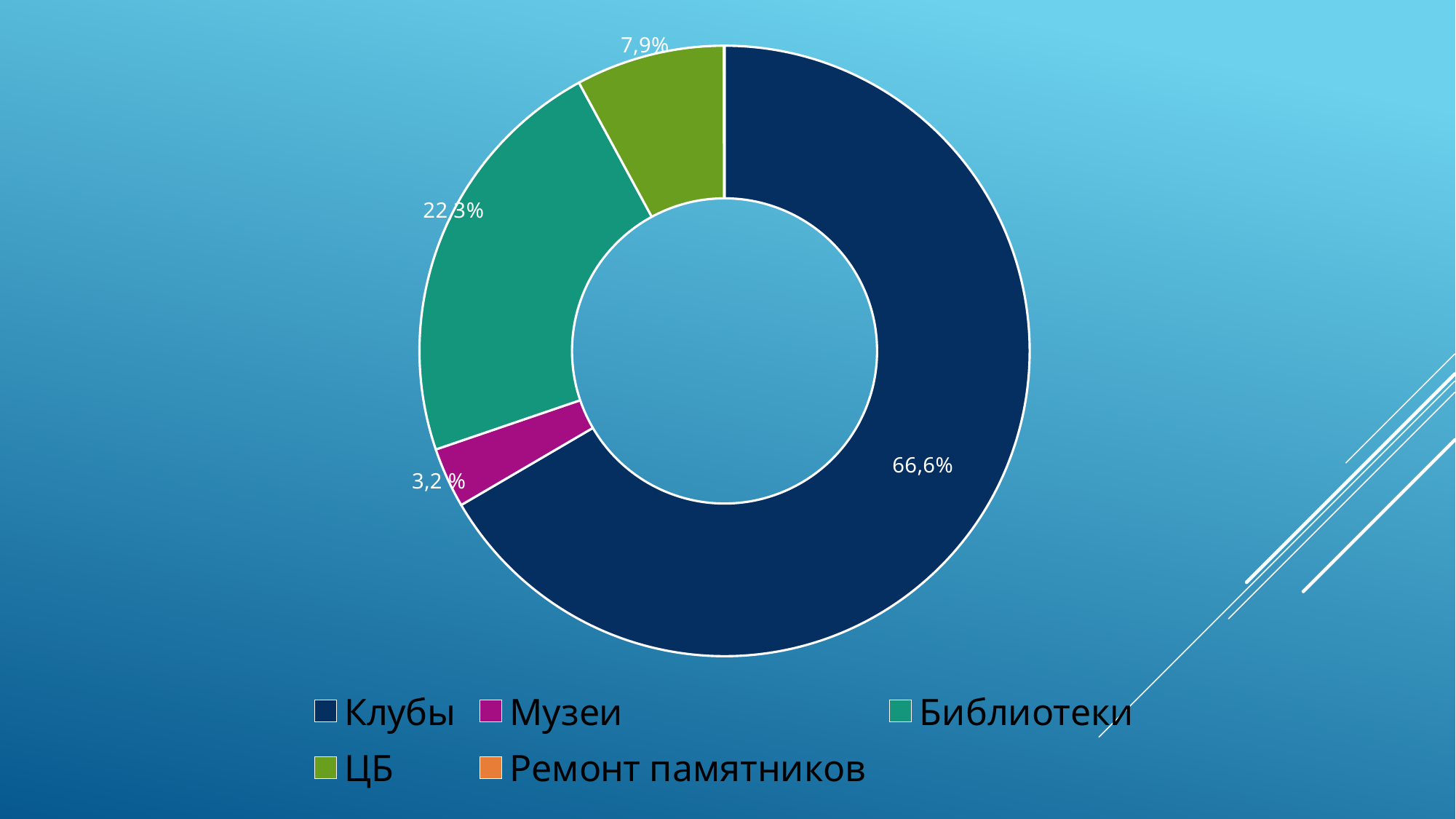
What percentage is shown for ЦБ? 7,9% What colour is the Музеи slice? magenta What is the difference in percentage points between Библиотеки and ЦБ? 14,4 What percentage is shown for Библиотеки? 22,3% Which category has the largest share of the chart? Клубы How many categories does the legend list? 5 What percentage is shown for Музеи? 3,2 % Which labelled category has the smallest share of the chart? Музеи What percentage is shown for Клубы? 66,6% What is the difference in percentage points between Клубы and Библиотеки? 44,3 What kind of chart is shown on the slide? doughnut chart Which has a larger share, Библиотеки or ЦБ? Библиотеки